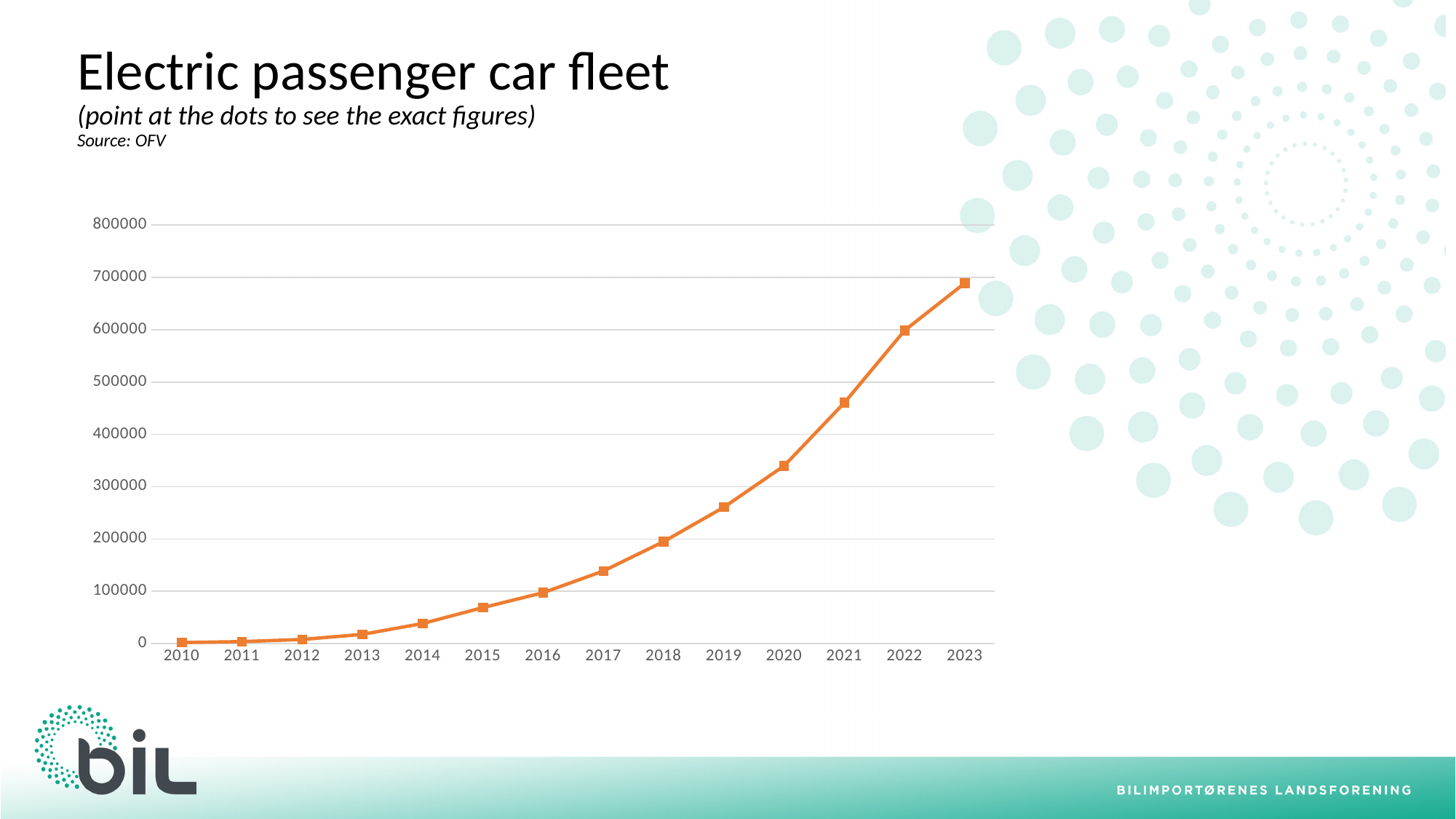
Is the value for 2020 greater or less than 300000? greater Do the values rise or fall from 2010 to 2023? rise Which year has the highest electric passenger car fleet value? 2023 What kind of chart is shown on the slide? line chart Is the value for 2023 greater or less than 600000? greater How many years are plotted on the x axis of the chart? 14 Which year has the lowest electric passenger car fleet value? 2010 Is the value for 2021 greater or less than 500000? less Which year has the larger value, 2019 or 2022? 2022 What is the source of the data cited on the slide? OFV